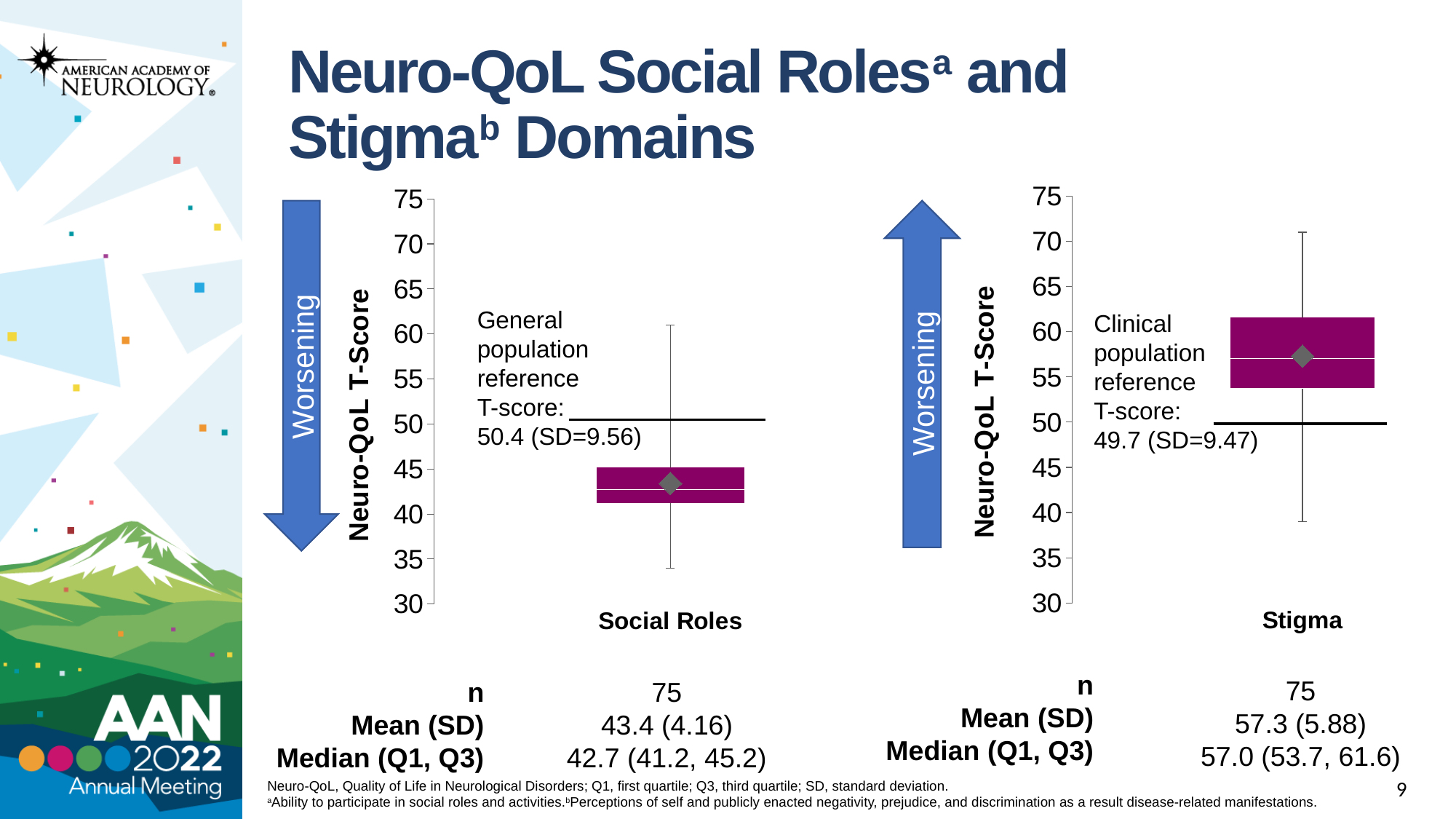
On the Social Roles chart, what is the mean (SD) Neuro-QoL T-score shown below the chart? 43.4 (4.16) On the Stigma chart, what is the median (Q1, Q3) Neuro-QoL T-score shown below the chart? 57.0 (53.7, 61.6) What is the y-axis label on the Social Roles chart? Neuro-QoL T-Score On the Social Roles chart, is the median T-score greater or less than 50? less On the Stigma chart, is the median T-score greater or less than 50? greater On the Stigma chart, what clinical population reference T-score is annotated? 49.7 (SD=9.47) On the Stigma chart, in which direction does the 'Worsening' arrow point? Up On the Social Roles chart, what general population reference T-score is annotated? 50.4 (SD=9.56) Which domain has the higher mean T-score, Social Roles or Stigma? Stigma What is the difference between the mean T-score for Stigma (57.3) and the mean T-score for Social Roles (43.4)? 13.9 On the Stigma chart, what is the sample size n shown below the chart? 75 What kind of chart is used to display the Social Roles and Stigma T-scores? Box plot